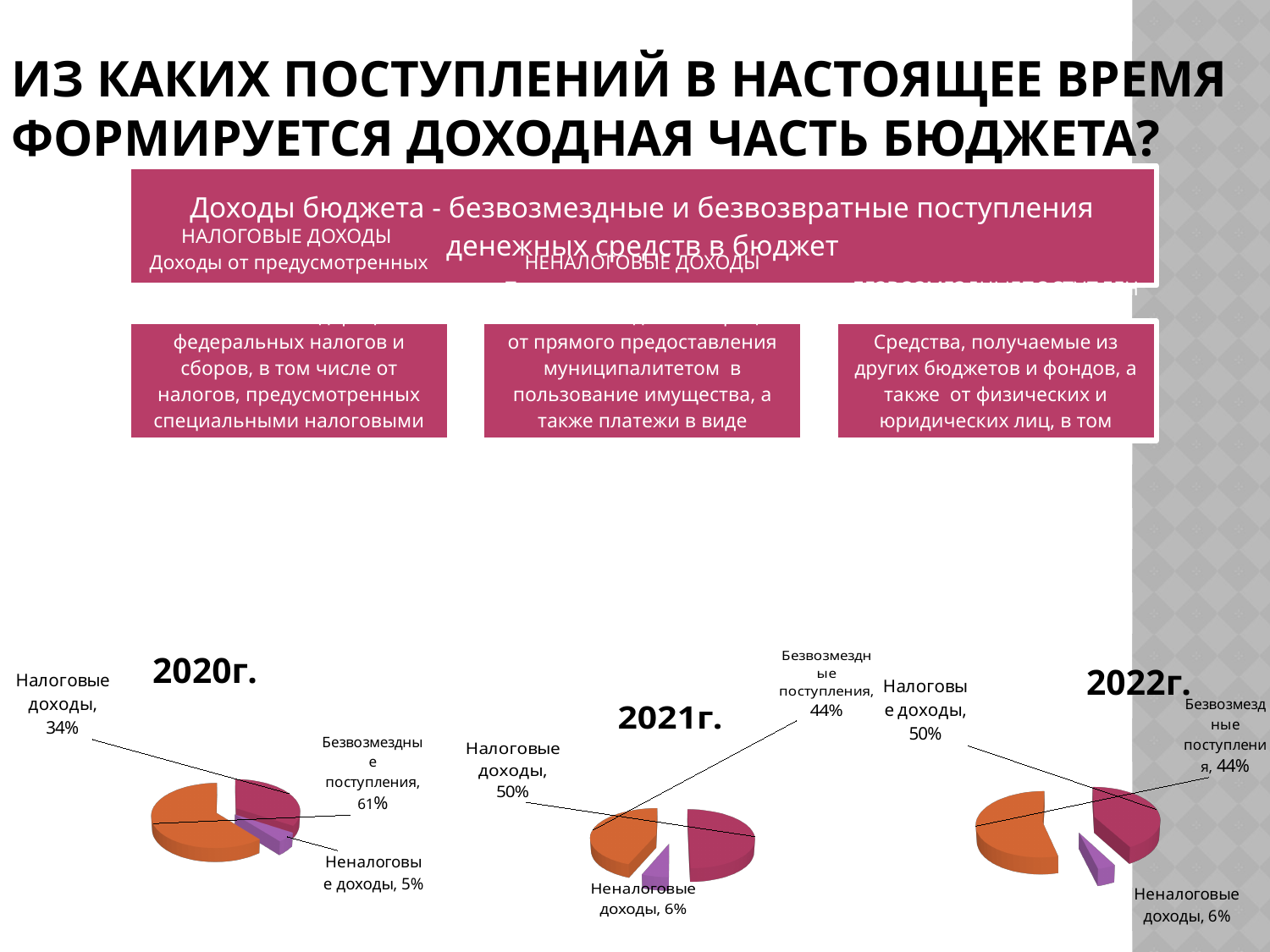
In the 2020г. pie chart, which category has the largest share? Безвозмездные поступления In the 2020г. pie chart, what share is shown for Налоговые доходы? 34% In the 2021г. pie chart, what share is shown for Налоговые доходы? 50% In the 2021г. pie chart, what is the difference between the shares of Налоговые доходы and Безвозмездные поступления? 6% In the 2020г. pie chart, which category has the smallest share? Неналоговые доходы In the 2020г. pie chart, what share is shown for Безвозмездные поступления? 61% In the 2021г. pie chart, what share is shown for Неналоговые доходы? 6% In the 2022г. pie chart, which is larger: Налоговые доходы or Безвозмездные поступления? Налоговые доходы What type of chart is used for 2021г.? Pie chart How many pie charts are shown on the slide? 3 How many slices does the 2022г. pie chart have? 3 In the 2022г. pie chart, what share is shown for Безвозмездные поступления? 44%